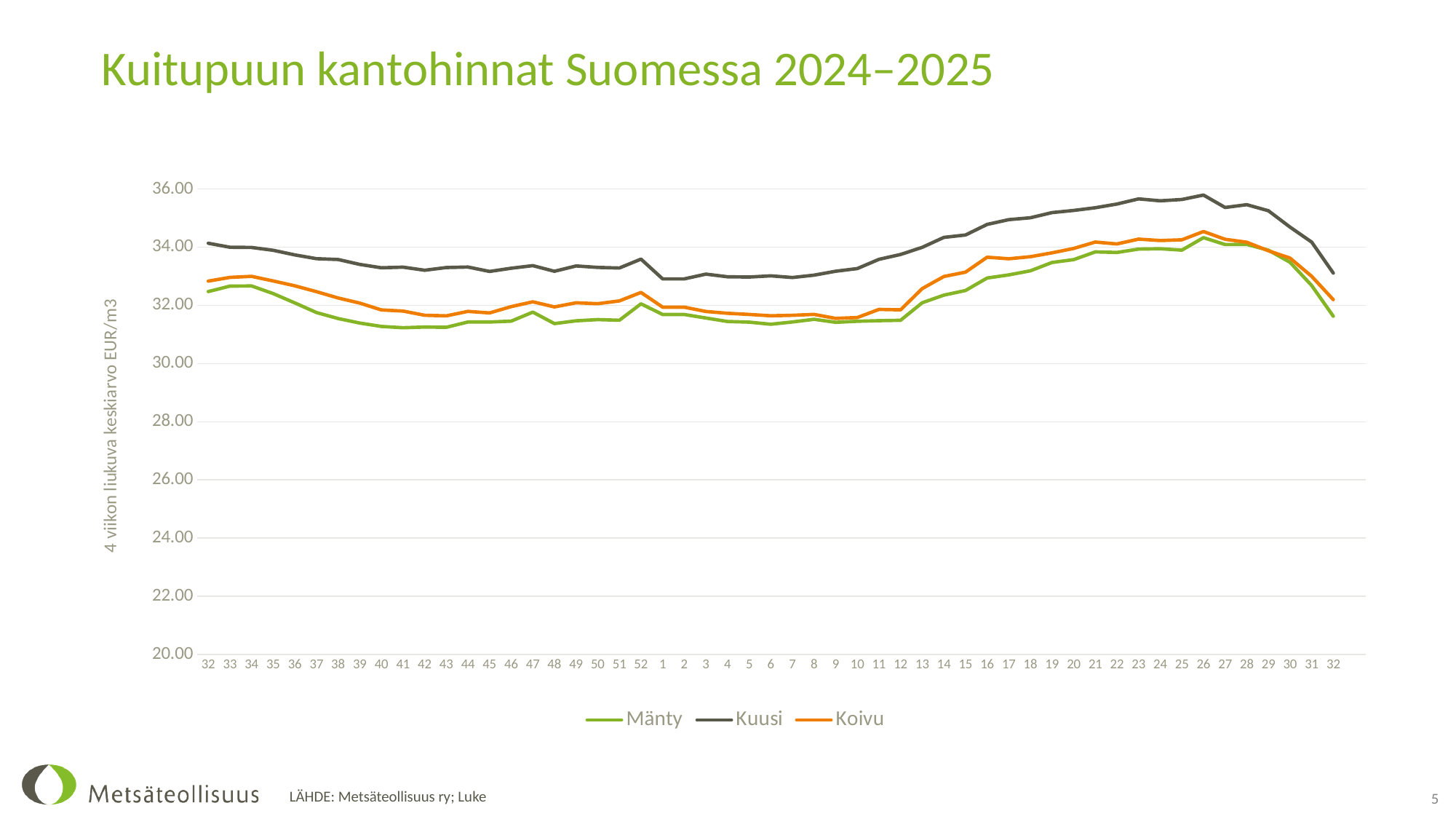
Which series has the highest values across the whole chart? Kuusi How many week points are plotted along the x axis? 53 Is the value for Mänty at week 41 greater or less than 32.00? less Does the Kuusi line rise or fall from week 13 to week 26? rise Which series are listed in the legend? Mänty, Kuusi, Koivu At week 26, which is larger, Kuusi or Mänty? Kuusi How many series does the legend list? 3 What kind of chart is shown on the slide? line chart What is the title of the chart? Kuitupuun kantohinnat Suomessa 2024–2025 At week 16, which is larger, Kuusi or Koivu? Kuusi Is the value for Kuusi at week 26 greater or less than 34.00? greater Is the value for Kuusi at the last week 32 greater or less than 32.00? greater